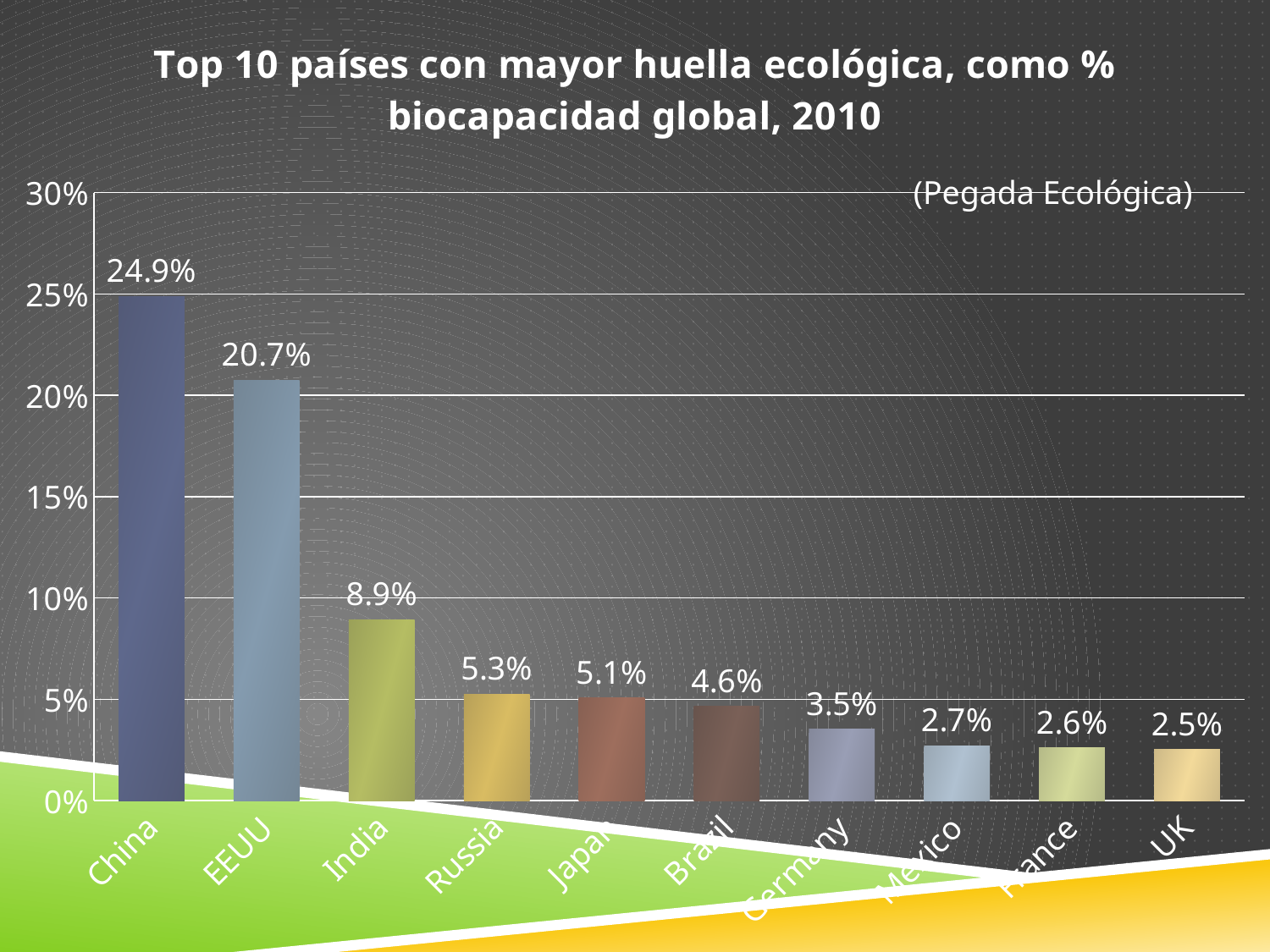
What is the value for India? 8.9% What is the value for China? 24.9% Which is larger, the value for India or the value for Brazil? India What is the value for Russia? 5.3% What kind of chart is shown on the slide? Bar chart What is the difference between the values for China and EEUU? 4.2% What is the value for UK? 2.5% Which country has the lowest value? UK Is the value for EEUU greater or less than 20%? greater Which country has the highest value? China How many countries are shown in the chart? 10